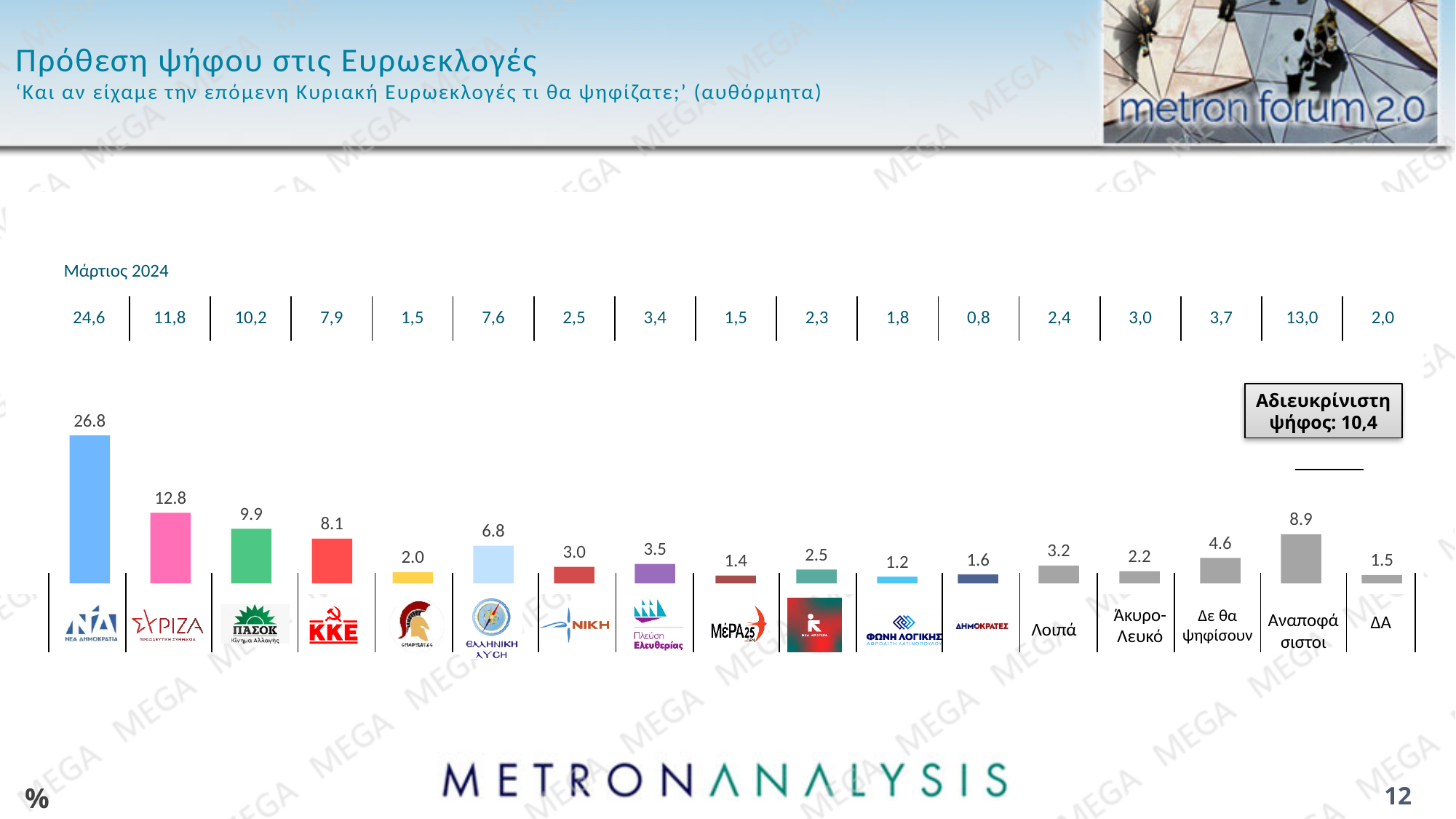
Which category has the highest bar in the chart? ΝΔ (Νέα Δημοκρατία) What is the difference between the values for ΝΔ and ΣΥΡΙΖΑ? 14.0 What is the value shown for Αναποφάσιστοι in the bar chart? 8.9 What is the value shown for ΣΥΡΙΖΑ in the bar chart? 12.8 What is the value shown for ΝΔ (Νέα Δημοκρατία) in the bar chart? 26.8 Which is larger, the value for Πλεύση Ελευθερίας or the value for ΝΙΚΗ? Πλεύση Ελευθερίας How many bars are plotted in the chart? 17 Which category has the lowest bar in the chart? Φωνή Λογικής What kind of chart is shown on the slide? Bar chart Which is larger, the value for ΠΑΣΟΚ or the value for ΚΚΕ? ΠΑΣΟΚ What value is given for 'Αδιευκρίνιστη ψήφος' in the box on the chart? 10,4 What is the value shown for Ελληνική Λύση in the bar chart? 6.8